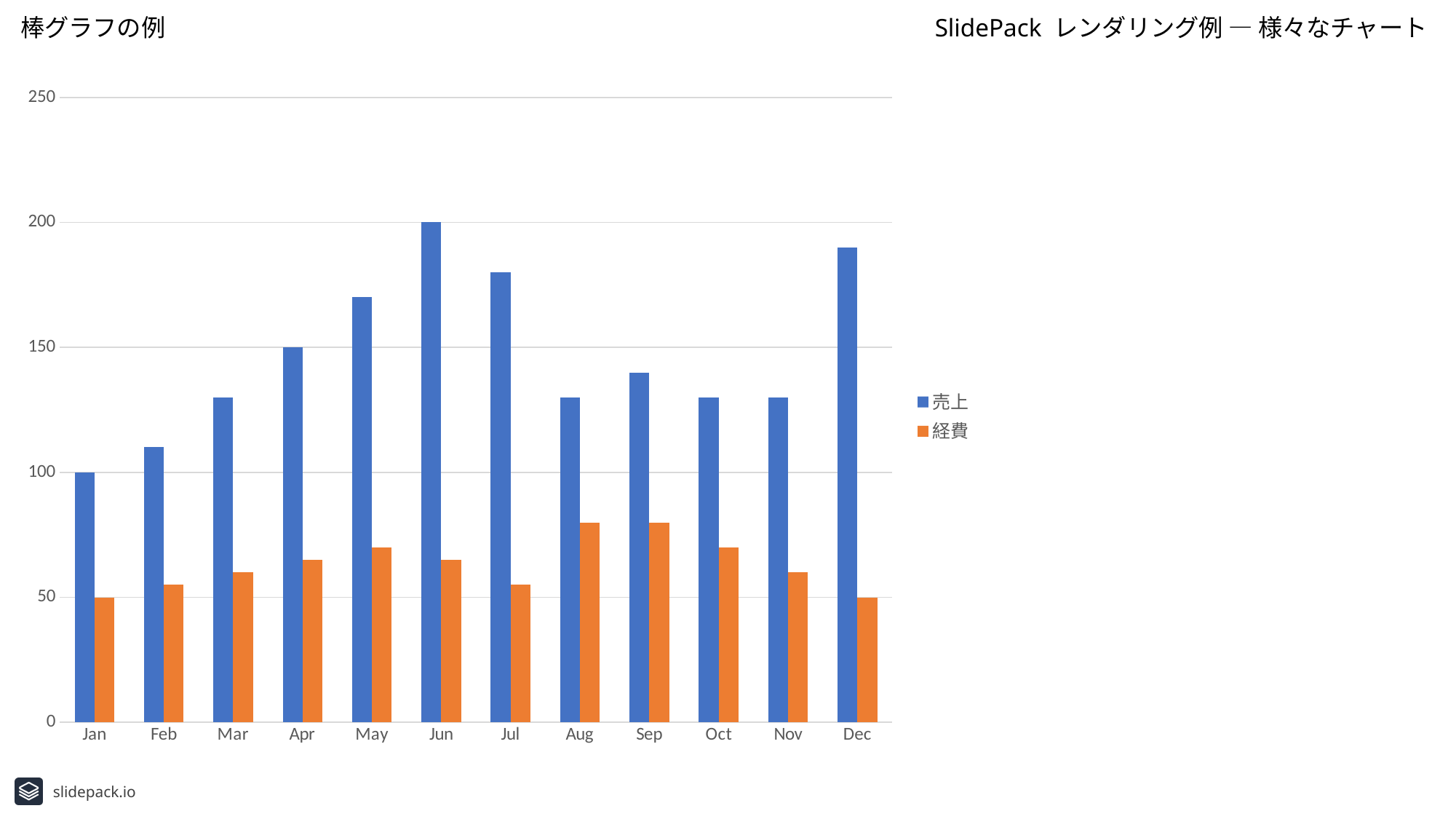
What is the 売上 value for Jun? 200 Which month has the lowest 売上 value? Jan How many series does the legend list? 2 What is the title of the chart? 棒グラフの例 Which month has the highest 売上 value? Jun Is the 売上 value for Dec greater or less than 150? greater What kind of chart is shown on the slide? bar chart What is the 売上 value for Apr? 150 Which is larger, the 売上 value for Jul or the 売上 value for Sep? Jul How many months are shown on the x axis? 12 What is the 売上 value for Jan? 100 Is the 経費 value for Aug greater or less than 100? less